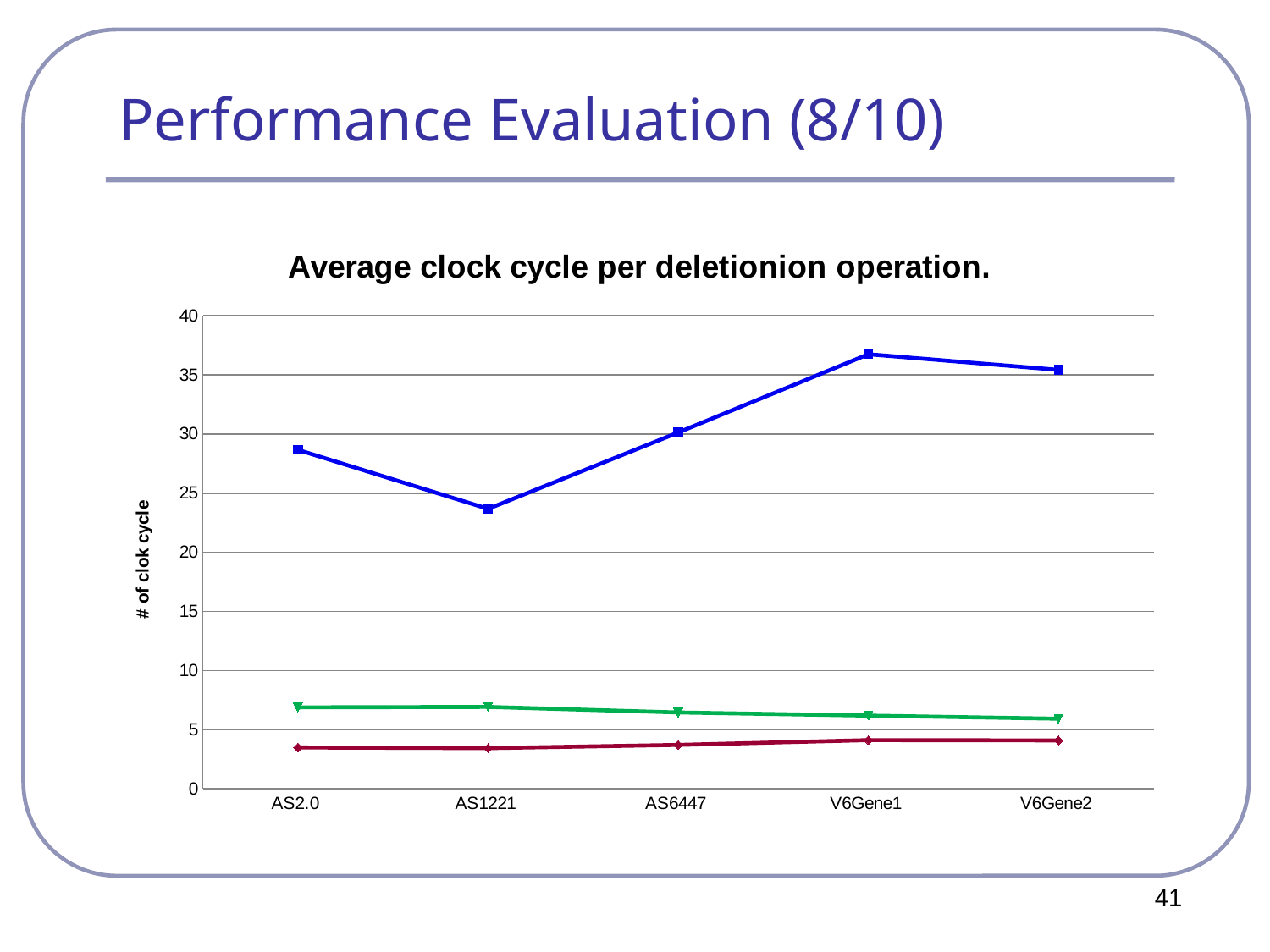
For the blue line, which category has the highest value? V6Gene1 For the blue line, which is larger: the value for V6Gene1 or the value for AS2.0? V6Gene1 What is the label on the vertical axis of the chart? # of clok cycle For the blue line, which category has the lowest value? AS1221 Is the value of the blue line for AS2.0 greater or less than 25? greater How many categories are shown along the x axis? 5 Is the value of the blue line for V6Gene1 greater or less than 35? greater Is the value of the blue line for AS1221 greater or less than 25? less What is the title of the chart? Average clock cycle per deletionion operation. What kind of chart is shown on the slide? line chart How many lines are plotted on the chart? 3